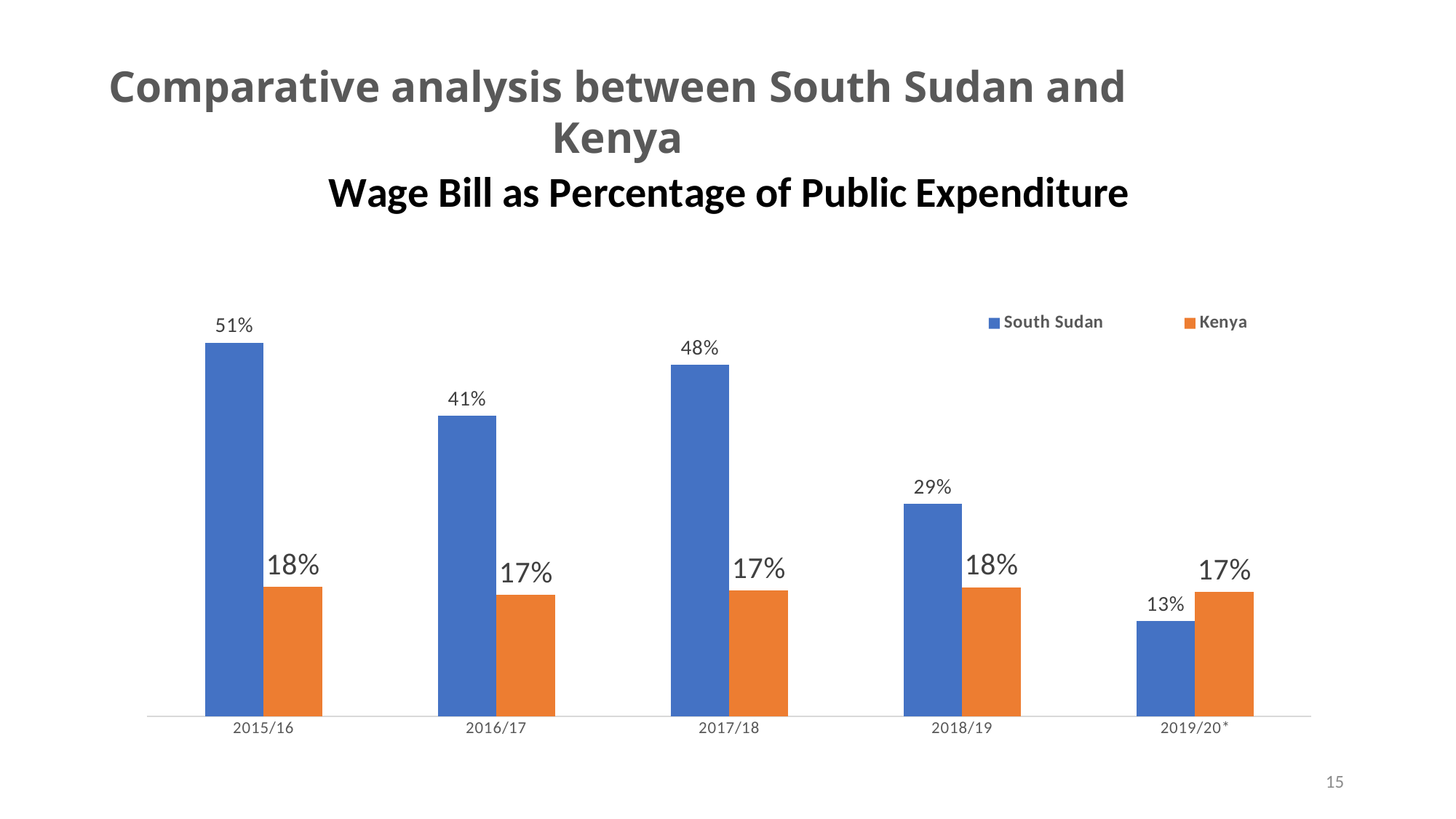
What is the difference between the South Sudan and Kenya values in 2017/18? 31% In which year is the South Sudan value highest? 2015/16 What is the title of the chart? Wage Bill as Percentage of Public Expenditure How many years are shown on the x axis? 5 What is the wage bill as a percentage of public expenditure for South Sudan in 2015/16? 51% What is the value for South Sudan in 2019/20*? 13% In which year is the South Sudan value lowest? 2019/20* What is the value for Kenya in 2017/18? 17% Which is larger in 2019/20*, the South Sudan value or the Kenya value? Kenya Which is larger in 2018/19, the South Sudan value or the Kenya value? South Sudan What kind of chart is shown on the slide? Bar chart How many series does the legend list? 2